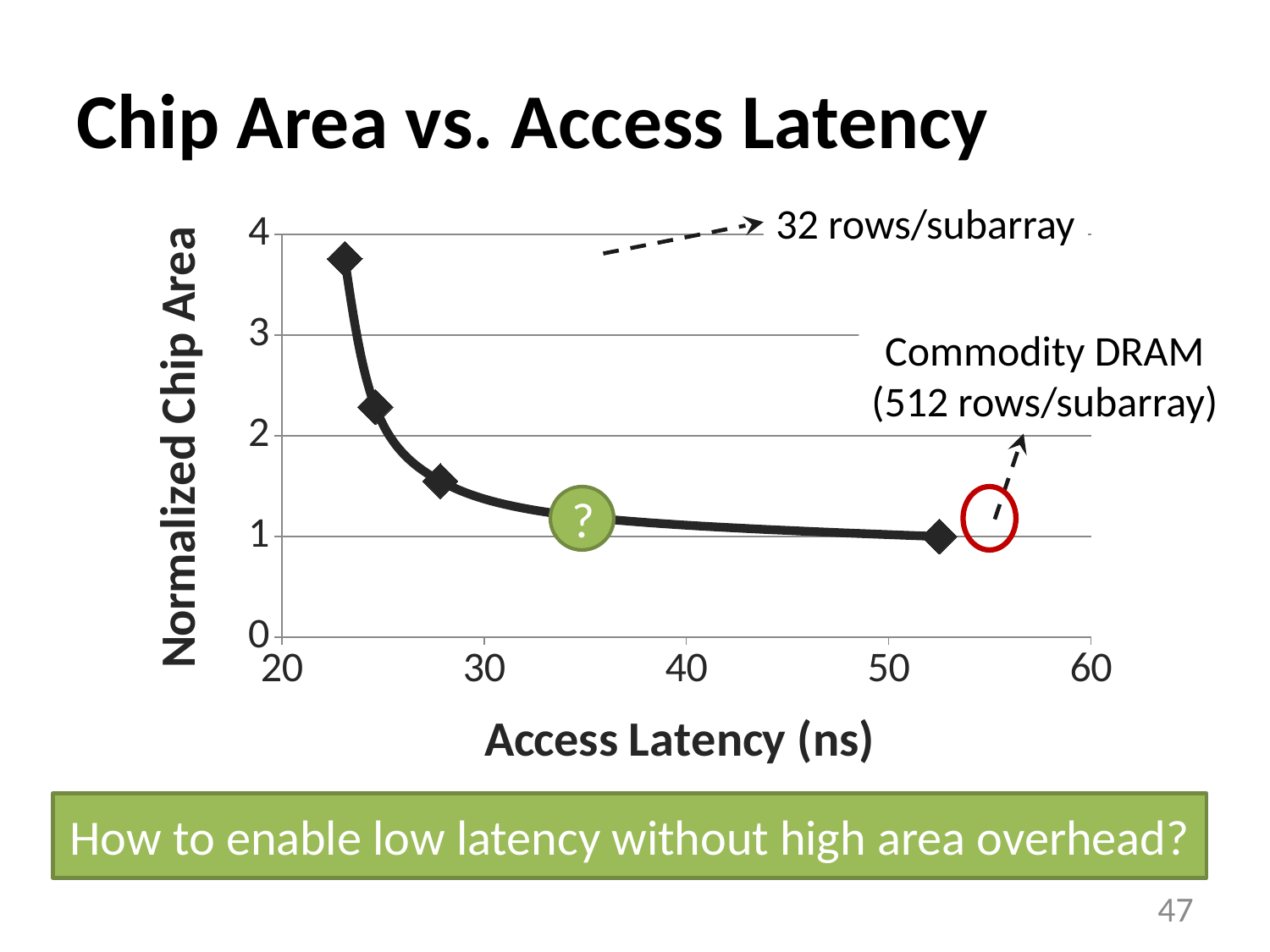
What kind of chart is shown on the slide? line chart Is the normalized chip area for the point with the lowest access latency greater or less than 3? greater Is the normalized chip area for the point at about 28 ns access latency greater or less than 2? less Is the access latency of the 32 rows/subarray point greater or less than 30 ns? less What is the normalized chip area of the Commodity DRAM (512 rows/subarray) point? 1 Which point has the highest normalized chip area: the 32 rows/subarray point or the Commodity DRAM point? 32 rows/subarray What is the label of the x axis? Access Latency (ns) As access latency increases along the x axis, does the normalized chip area rise or fall? fall What is the title of the chart? Chip Area vs. Access Latency